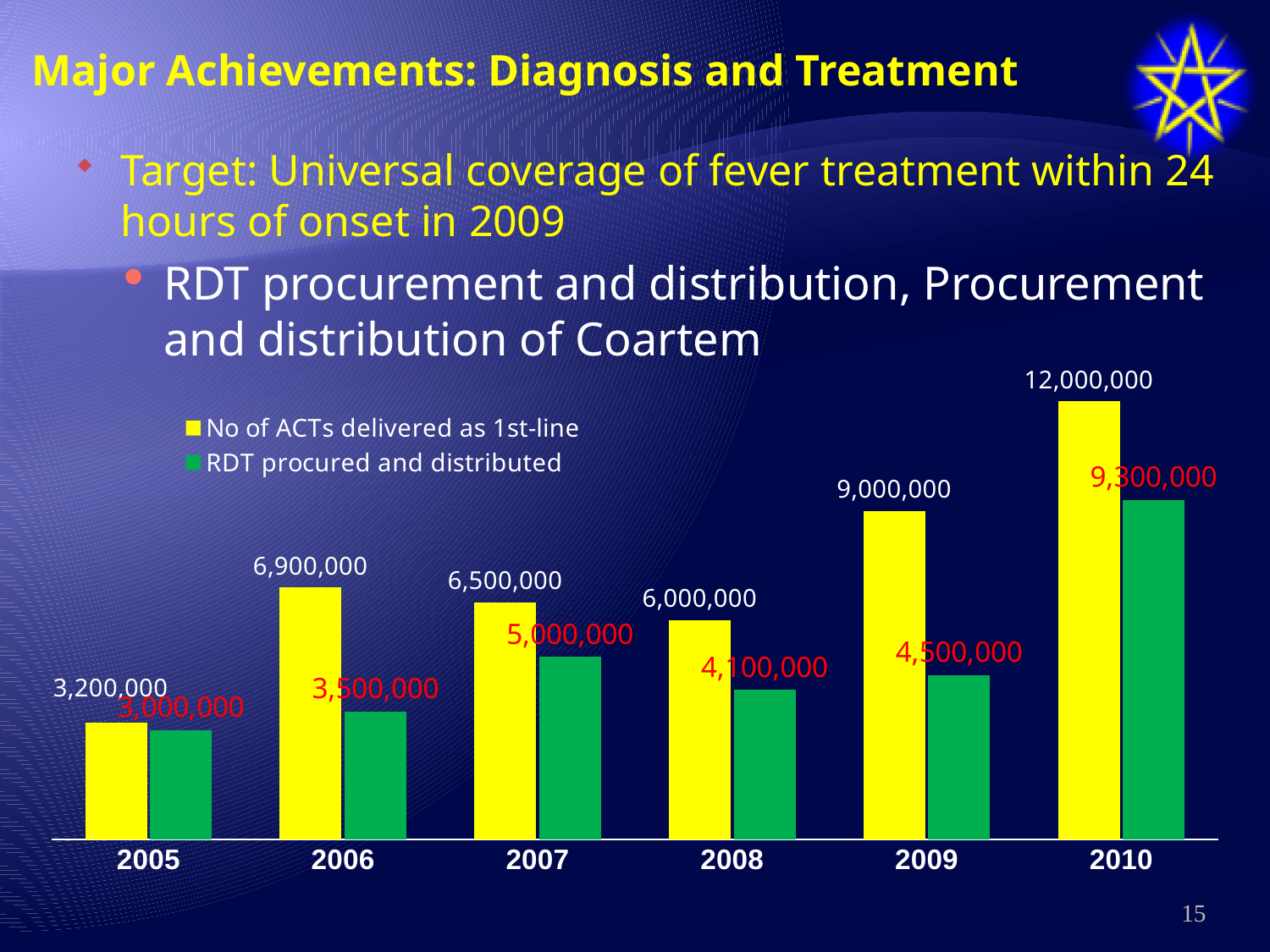
What is the number of ACTs delivered as 1st-line in 2010? 12,000,000 In which year was the number of ACTs delivered as 1st-line highest? 2010 What is the number of ACTs delivered as 1st-line in 2005? 3,200,000 Did the number of ACTs delivered as 1st-line rise or fall from 2006 to 2008? Fall Which colour represents RDT procured and distributed in the chart? Green In which year was RDT procured and distributed lowest? 2005 How many series does the chart legend list? 2 What is the value for RDT procured and distributed in 2007? 5,000,000 What is the difference between ACTs delivered as 1st-line and RDT procured and distributed in 2009? 4,500,000 Which is larger in 2006: the number of ACTs delivered as 1st-line or RDT procured and distributed? No of ACTs delivered as 1st-line How many years are shown on the x axis of the chart? 6 What kind of chart is shown on the slide? Bar chart